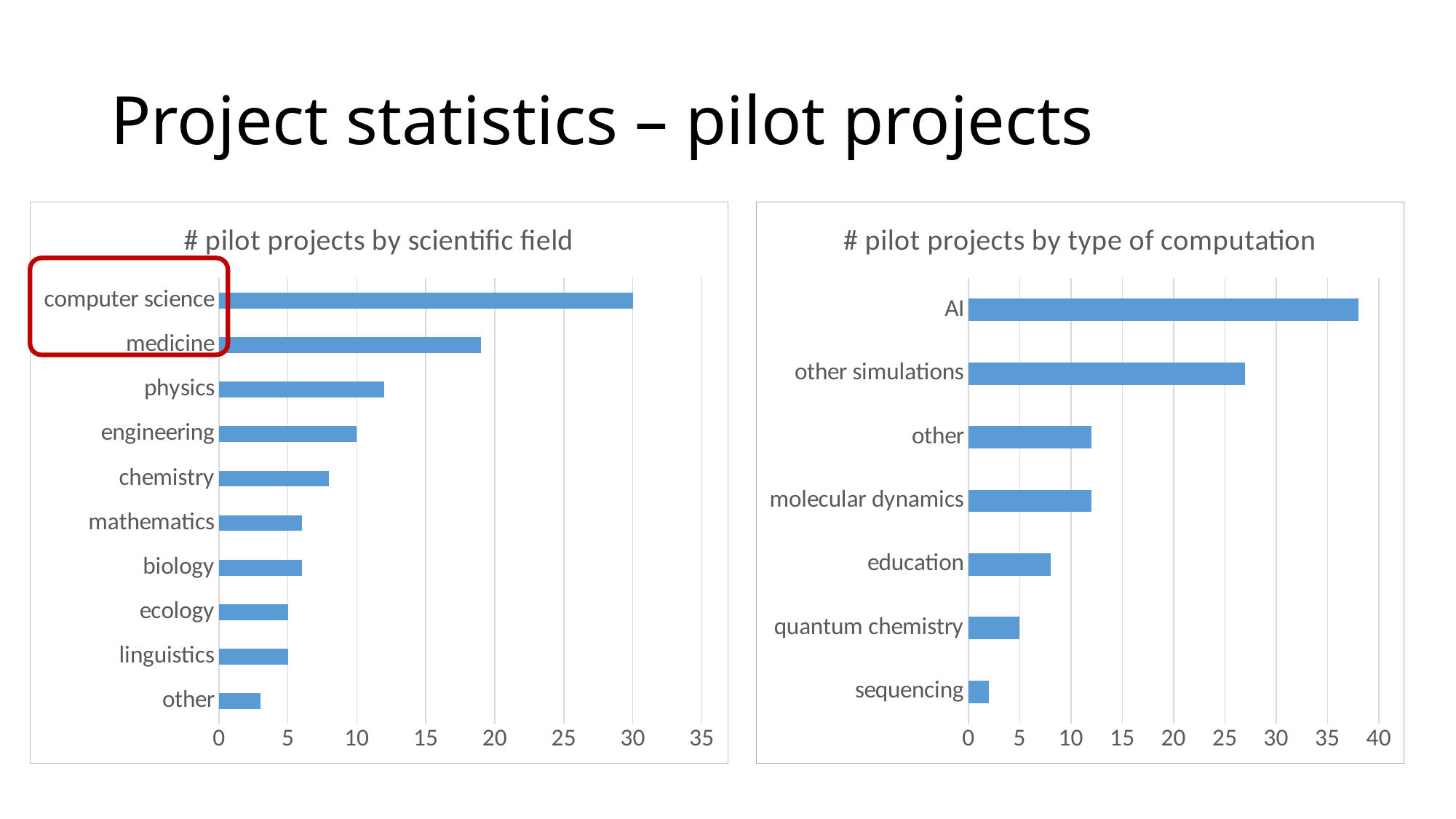
In '# pilot projects by scientific field', is the value for medicine greater or less than 15? greater In '# pilot projects by type of computation', is the value for AI greater or less than 35? greater What kind of chart is '# pilot projects by scientific field'? bar chart In '# pilot projects by type of computation', how many types of computation are listed? 7 In '# pilot projects by type of computation', which type of computation has the most pilot projects? AI In '# pilot projects by scientific field', which category has the fewest pilot projects? other In '# pilot projects by scientific field', which has more pilot projects, medicine or physics? medicine In '# pilot projects by scientific field', how many pilot projects does computer science have? 30 In '# pilot projects by type of computation', which type of computation has the fewest pilot projects? sequencing In '# pilot projects by scientific field', how many scientific field categories are shown? 10 In '# pilot projects by scientific field', how many pilot projects does engineering have? 10 In '# pilot projects by scientific field', which scientific field has the most pilot projects? computer science